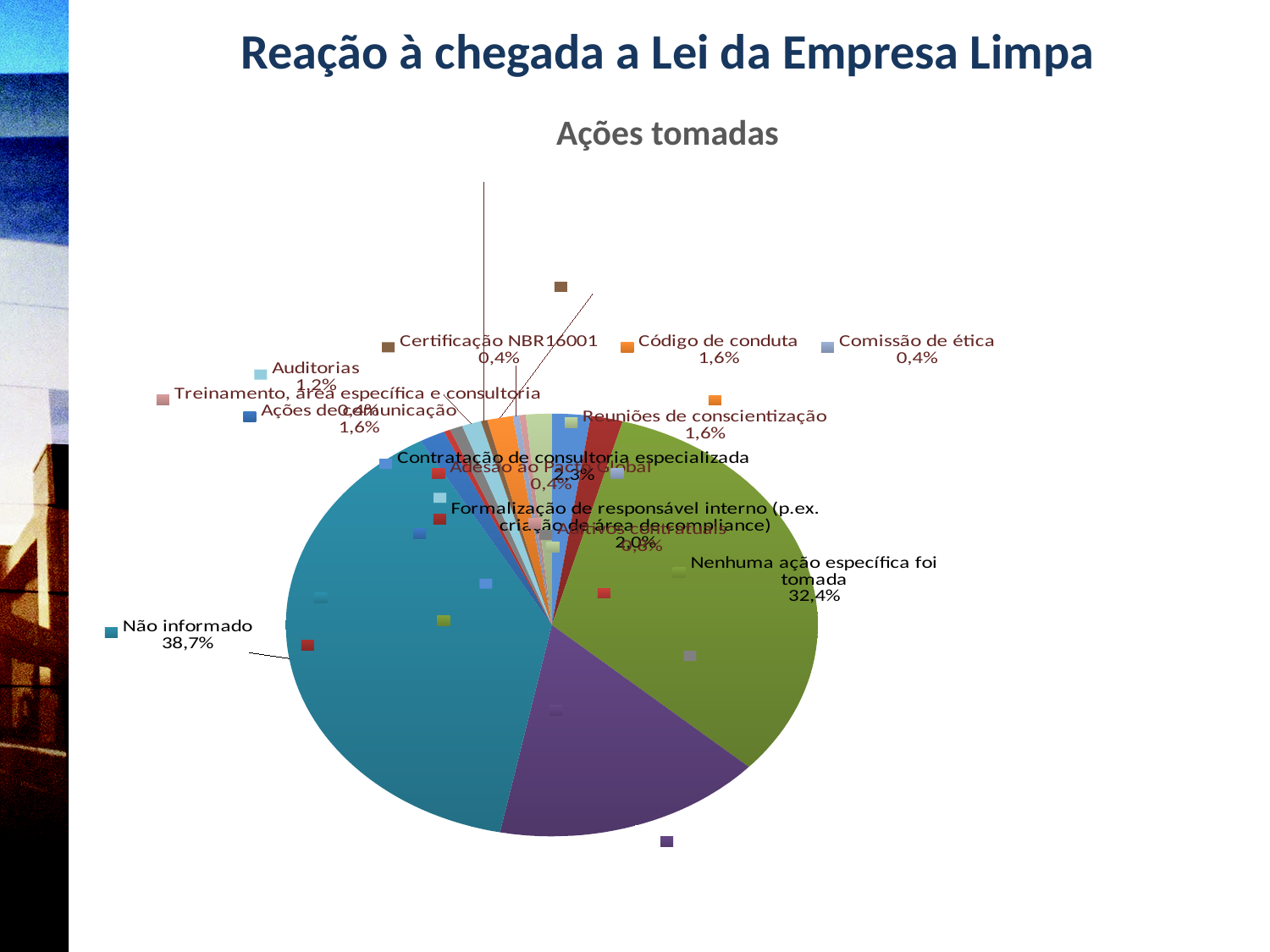
What is the difference between the shares for "Não informado" and "Nenhuma ação específica foi tomada"? 6,3% What percentage is shown for "Não informado"? 38,7% What percentage is shown for "Comissão de ética"? 0,4% Which is larger, the share for "Não informado" or for "Nenhuma ação específica foi tomada"? Não informado Which labelled category has the largest share of the pie? Não informado What percentage is shown for "Auditorias"? 1,2% What percentage is shown for "Código de conduta"? 1,6% What percentage is shown for "Contratação de consultoria especializada"? 2,3% What kind of chart is shown on the slide? pie chart What percentage is shown for "Nenhuma ação específica foi tomada"? 32,4% What is the title of the chart? Ações tomadas What percentage is shown for "Reuniões de conscientização"? 1,6%